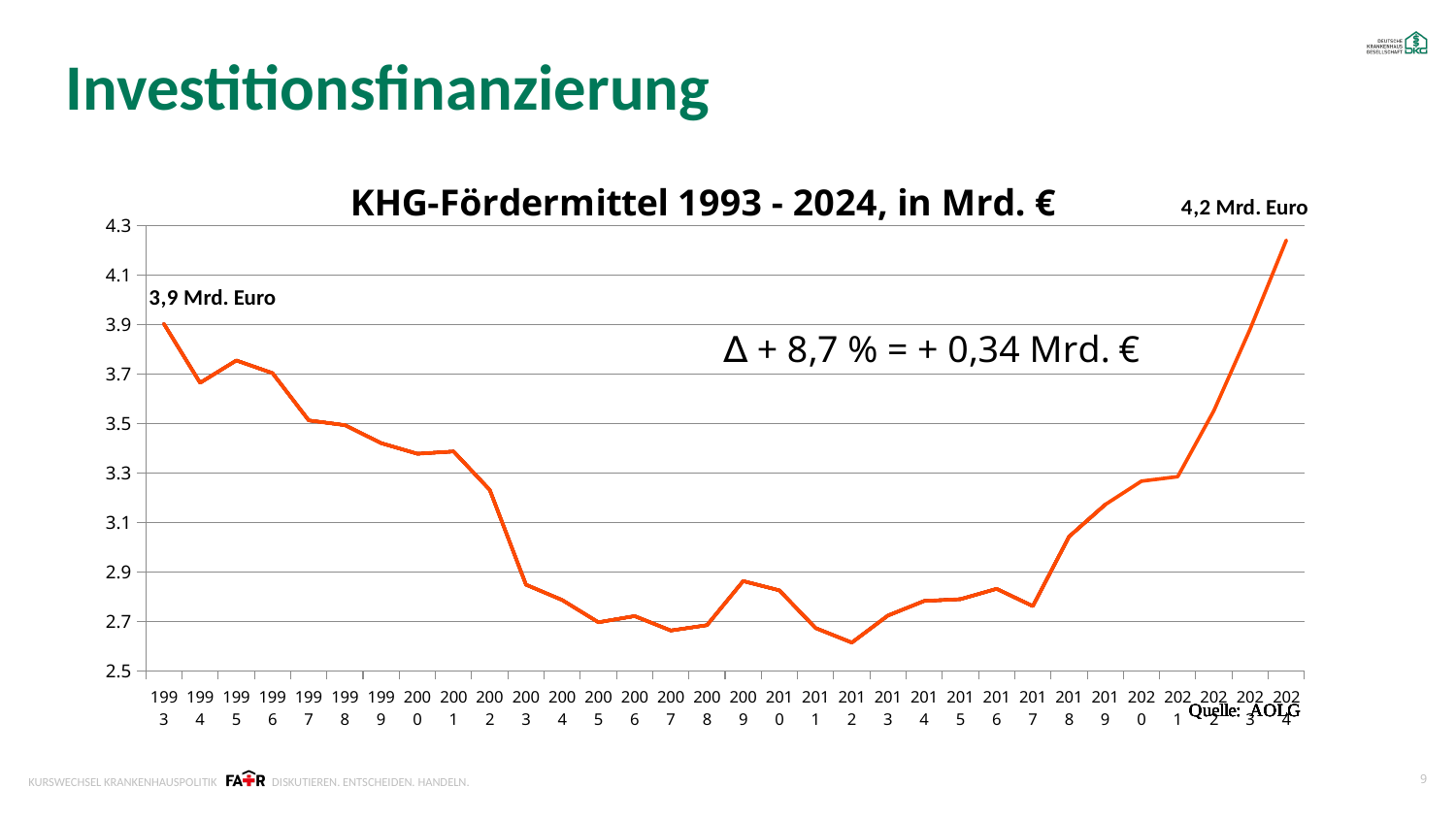
Which year has the highest value in the chart? 2024 What is the title of the chart? KHG-Fördermittel 1993 - 2024, in Mrd. € Which year has the lowest value in the chart? 2012 Is the value for 2020 greater or less than 3.1? greater How many years are plotted on the x axis? 32 Do the values rise or fall from 2017 to 2024? rise What value is labelled for the year 1993? 3,9 Mrd. Euro Is the value for 2003 greater or less than 2.9? less Is the value for 2002 greater or less than 3.3? less What value is labelled for the year 2024? 4,2 Mrd. Euro Which is larger, the value for 1993 or the value for 2024? 2024 What type of chart is shown on the slide? line chart